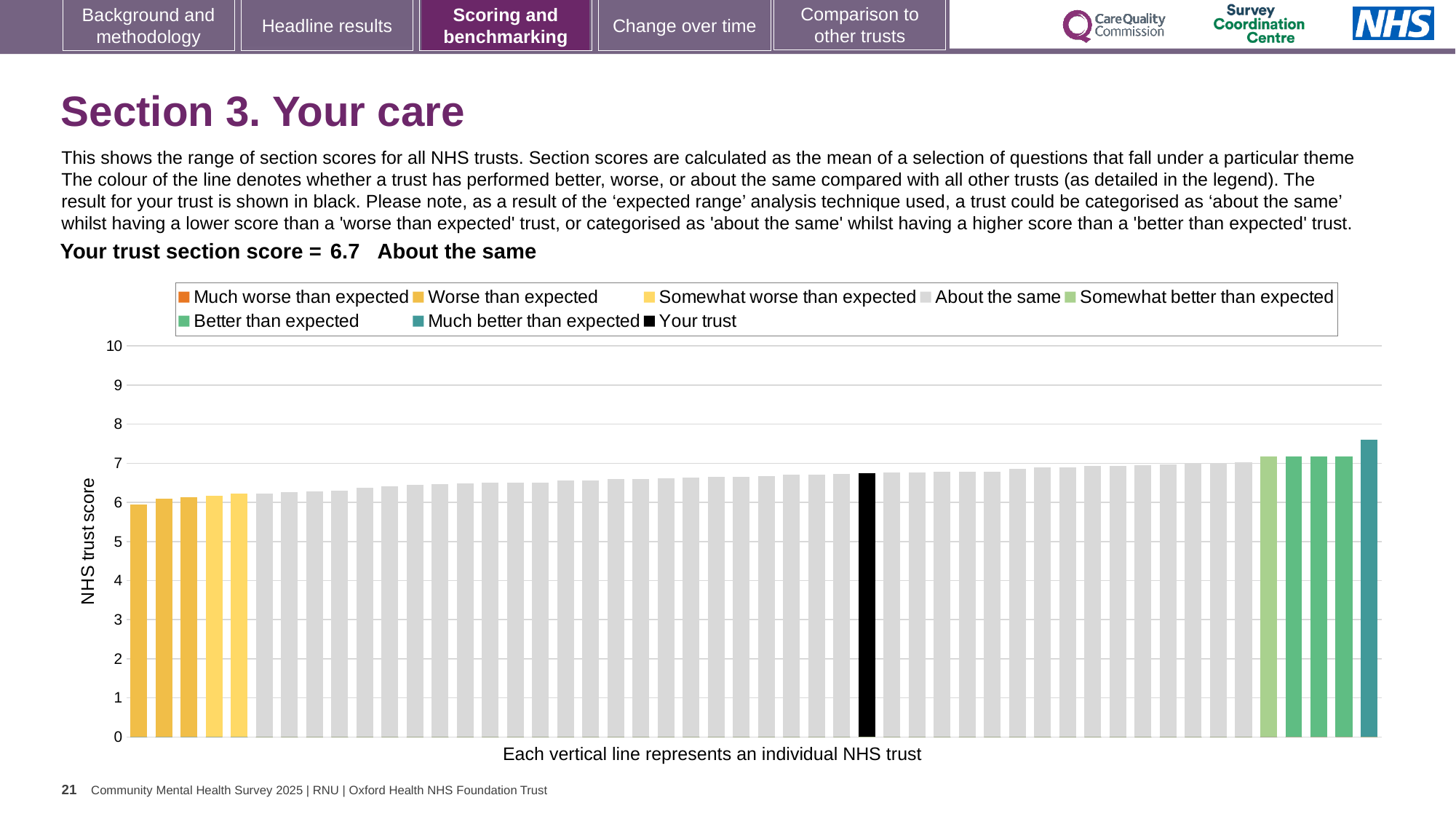
Is the value of the tallest bar in the chart greater or less than 7? greater Which legend category does the shortest bar in the chart belong to? Worse than expected Is the value of the shortest bar in the chart greater or less than 7? less Is the value of the bar for your trust greater or less than 6? greater What is the label on the vertical axis of the chart? NHS trust score Which category is your trust placed in for this section? About the same Do the bar values rise or fall from left to right along the x axis? rise Is the bar for your trust higher or lower than the 'Much better than expected' bar? lower What is the section score for your trust shown on the slide? 6.7 How many entries does the chart legend list? 8 Which legend category does the tallest bar in the chart belong to? Much better than expected What kind of chart is shown on the slide? Bar chart